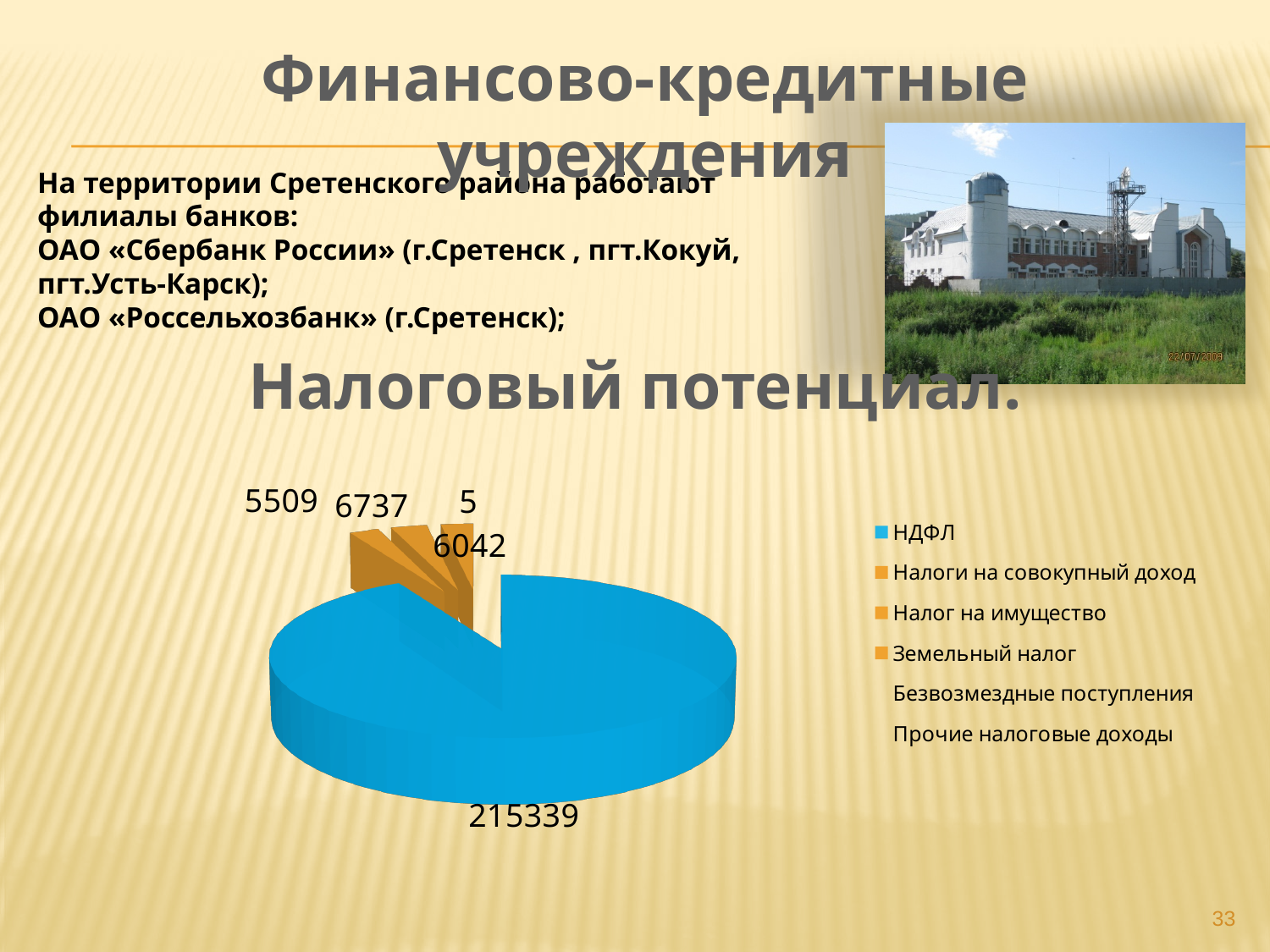
What is the title above the pie chart? Налоговый потенциал. What is the largest data label printed on the pie chart? 215339 What is the difference between the largest and the smallest data labels printed on the pie chart? 215334 What value is shown for НДФЛ in the pie chart? 215339 What colour is the НДФЛ slice in the pie chart? blue How many entries does the legend of the pie chart list? 6 Is the value for НДФЛ larger or smaller than the value labelled 6737? larger What kind of chart is shown on the slide? pie chart What is the smallest data label printed on the pie chart? 5 How many data labels are printed on the pie chart? 5 Which category has the largest slice in the pie chart? НДФЛ